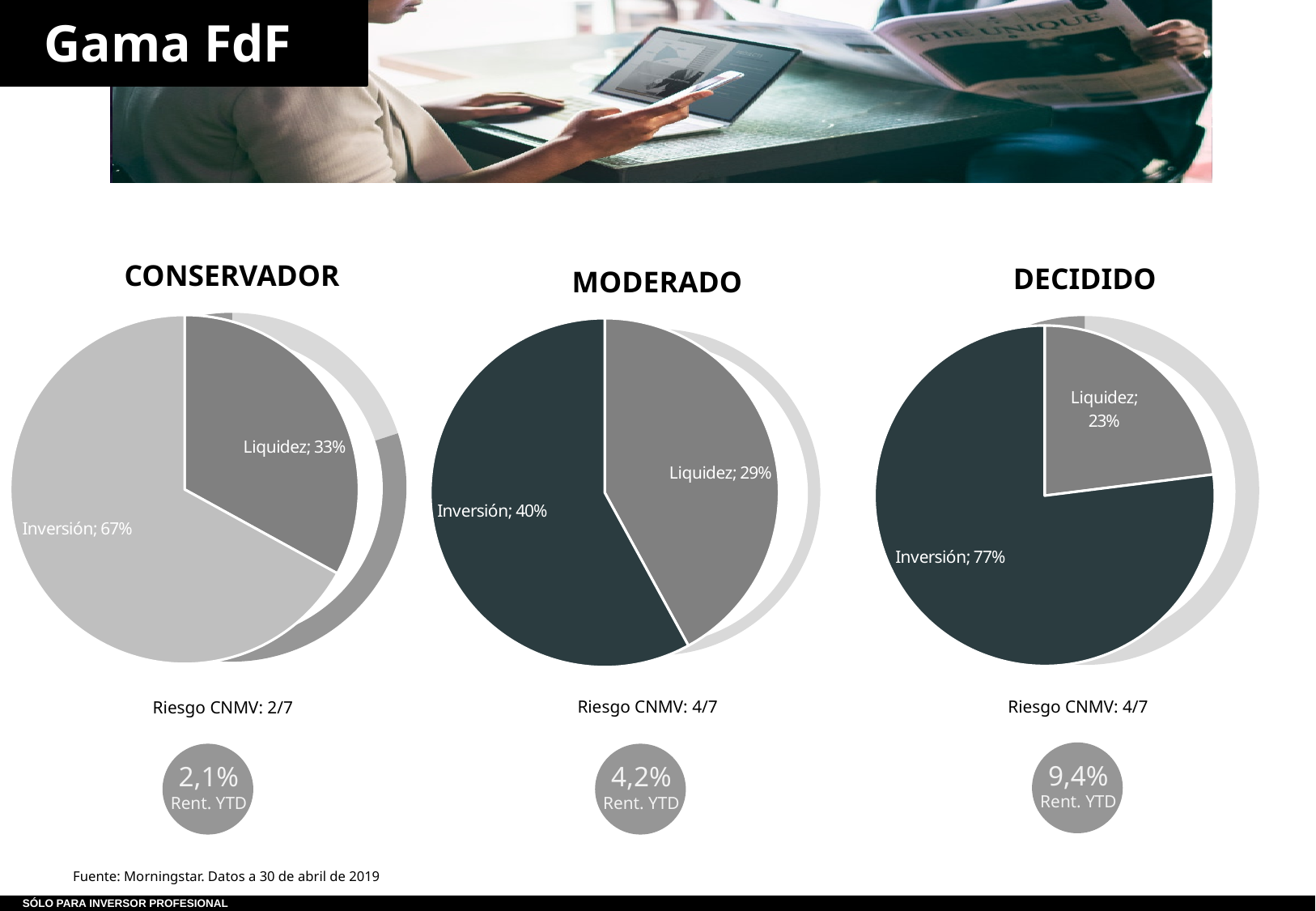
In the DECIDIDO pie chart, what is the value for Liquidez? 23% In the CONSERVADOR pie chart, what is the difference between the Inversión and Liquidez values? 34 percentage points In the CONSERVADOR pie chart, which slice is the smallest? Liquidez In the DECIDIDO pie chart, which slice is the largest? Inversión In the MODERADO pie chart, what is the value for Liquidez? 29% In the CONSERVADOR pie chart, what is the value for Liquidez? 33% In the CONSERVADOR pie chart, what is the value for Inversión? 67% What kind of chart is used for the CONSERVADOR, MODERADO and DECIDIDO portfolios? Pie chart How many slices does the DECIDIDO pie chart have? 2 In the MODERADO pie chart, what is the value for Inversión? 40% In the DECIDIDO pie chart, what is the value for Inversión? 77% In the MODERADO pie chart, which is larger, Inversión or Liquidez? Inversión